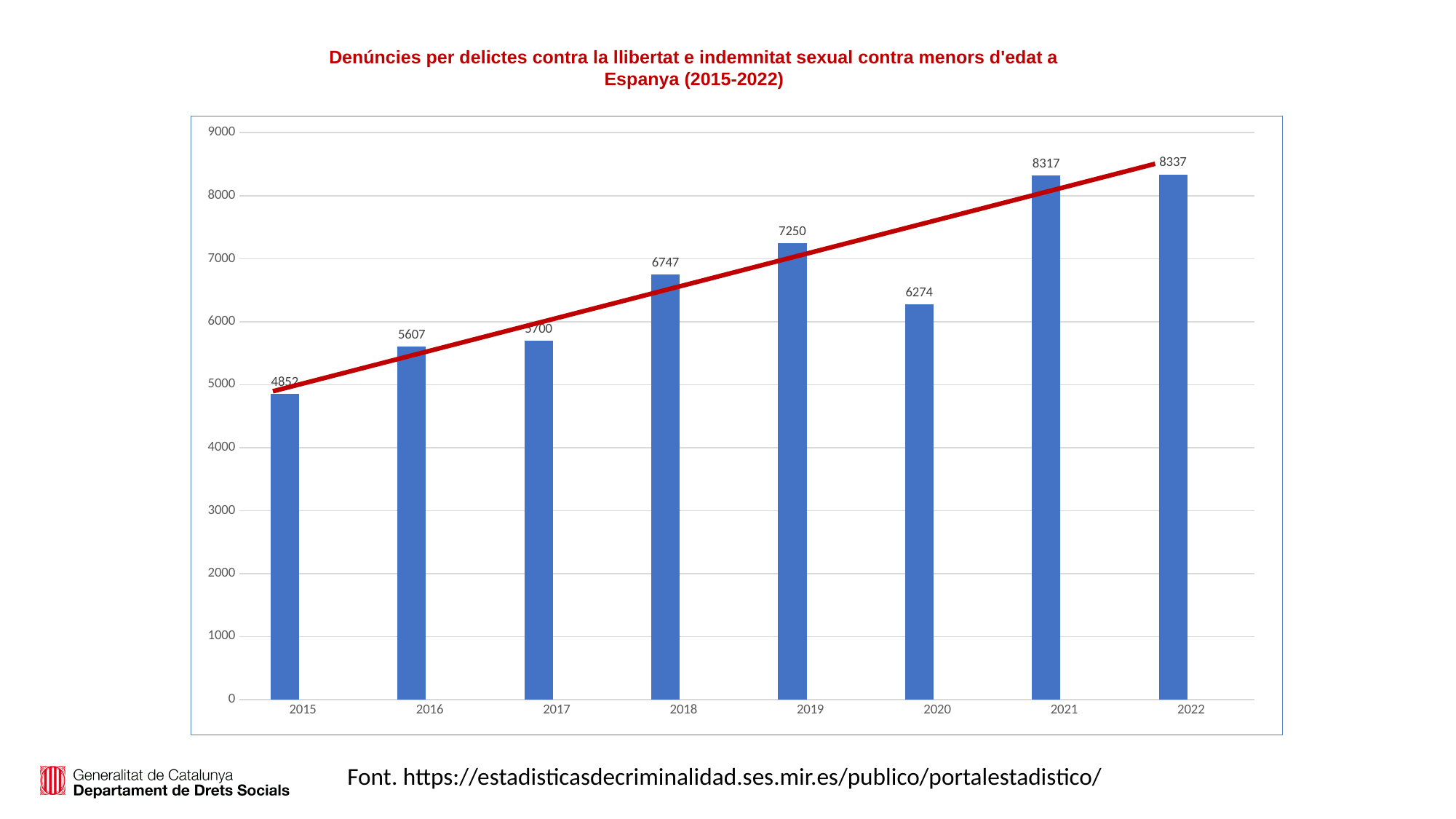
How many years are shown on the x axis? 8 Which year has the highest value? 2022 What is the value for 2020? 6274 What colour is the trend line drawn across the bars? red Which year has the lowest value? 2015 Is the value for 2021 greater or less than 8000? greater What is the value for 2015? 4852 What is the difference between the values for 2022 and 2015? 3485 Which is larger, the value for 2018 or the value for 2020? 2018 What kind of chart is shown on the slide? bar chart What is the difference between the values for 2019 and 2020? 976 What is the value for 2019? 7250